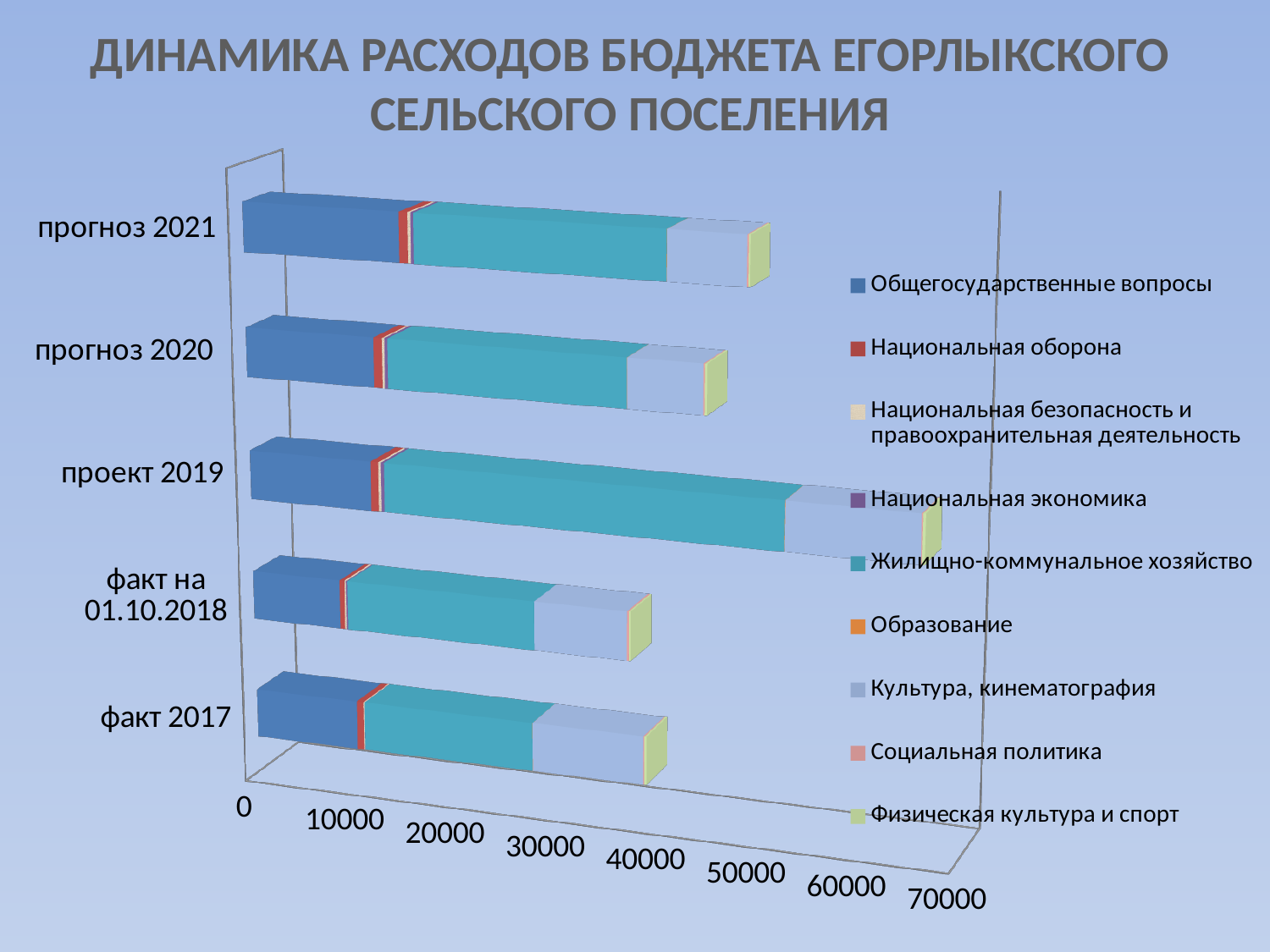
Is the total value for прогноз 2021 greater or less than 30000? greater How many series does the legend list? 9 Which series forms the largest segment of the проект 2019 bar? Жилищно-коммунальное хозяйство Which period has the longest (highest total) bar? проект 2019 Which series is shown as the first (leftmost) segment of each bar? Общегосударственные вопросы Which bar is longer: проект 2019 or прогноз 2020? проект 2019 How many categories (periods) are plotted on the chart? 5 What is the title of the chart? ДИНАМИКА РАСХОДОВ БЮДЖЕТА ЕГОРЛЫКСКОГО СЕЛЬСКОГО ПОСЕЛЕНИЯ Which bar is longer: прогноз 2021 or факт 2017? прогноз 2021 Is the total value for факт 2017 greater or less than 20000? greater Is the total value for проект 2019 greater or less than 50000? greater What kind of chart is shown on the slide? stacked bar chart